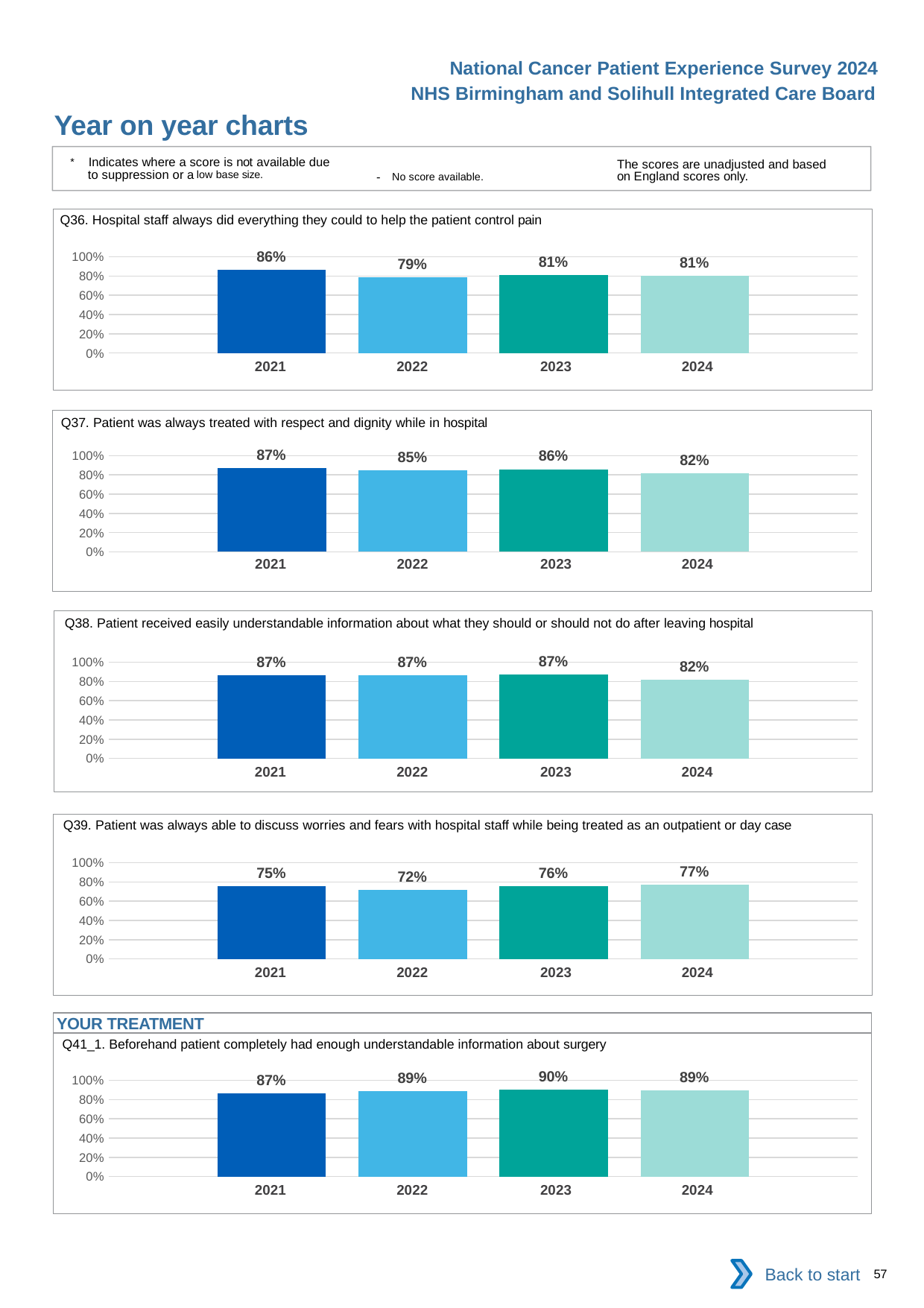
In the Q39 chart, which is larger, the value for 2022 or the value for 2024? 2024 In the Q36 chart, which year has the lowest value? 2022 In the Q38 chart, what is the value for 2024? 82% In the Q41_1 chart, what is the difference between the 2023 and 2021 values? 3% In the Q37 chart, what is the difference between the 2021 and 2024 values? 5% What kind of chart is the Q36 chart? Bar chart In the Q39 chart, what is the value for 2023? 76% In the Q39 chart, is the value for 2022 greater or less than 80%? less In the Q37 chart, which year has the highest value? 2021 In the Q41_1 chart, which year has the highest value? 2023 In the Q36 chart, what is the value for 2021? 86% In the Q38 chart, how many years are plotted? 4